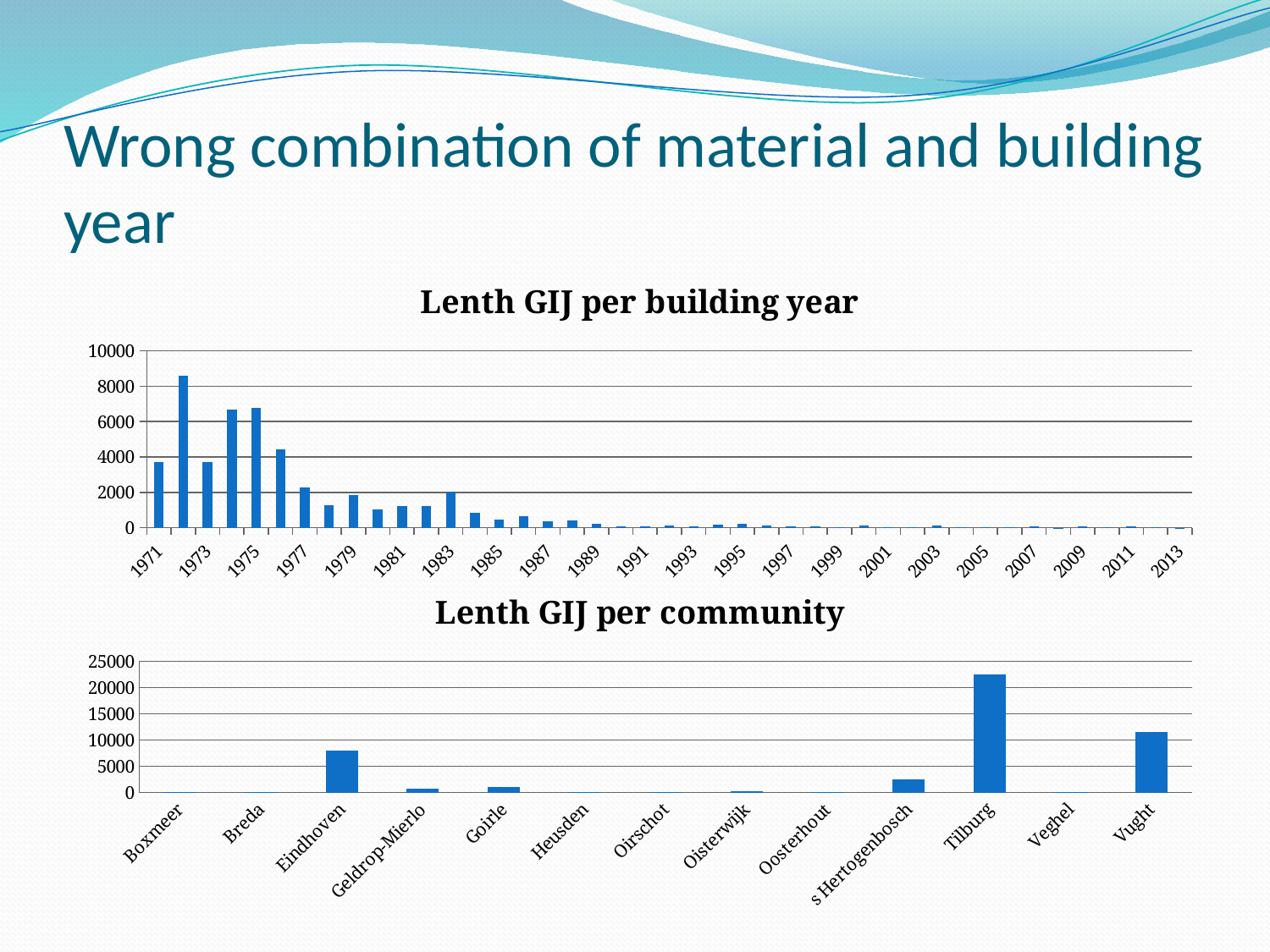
In the 'Lenth GIJ per building year' chart, is the value for 1972 greater or less than 8000? greater In the 'Lenth GIJ per community' chart, is the value for Vught greater or less than 10000? greater How many communities are shown in the 'Lenth GIJ per community' chart? 13 In the 'Lenth GIJ per community' chart, is the value for Eindhoven greater or less than 10000? less What kind of chart is the 'Lenth GIJ per building year' chart? bar chart In the 'Lenth GIJ per building year' chart, which year has the highest value? 1972 In the 'Lenth GIJ per community' chart, which is larger, the value for Vught or the value for Eindhoven? Vught In the 'Lenth GIJ per building year' chart, do the values generally rise or fall from 1972 to 2013? fall In the 'Lenth GIJ per community' chart, which community has the highest value? Tilburg